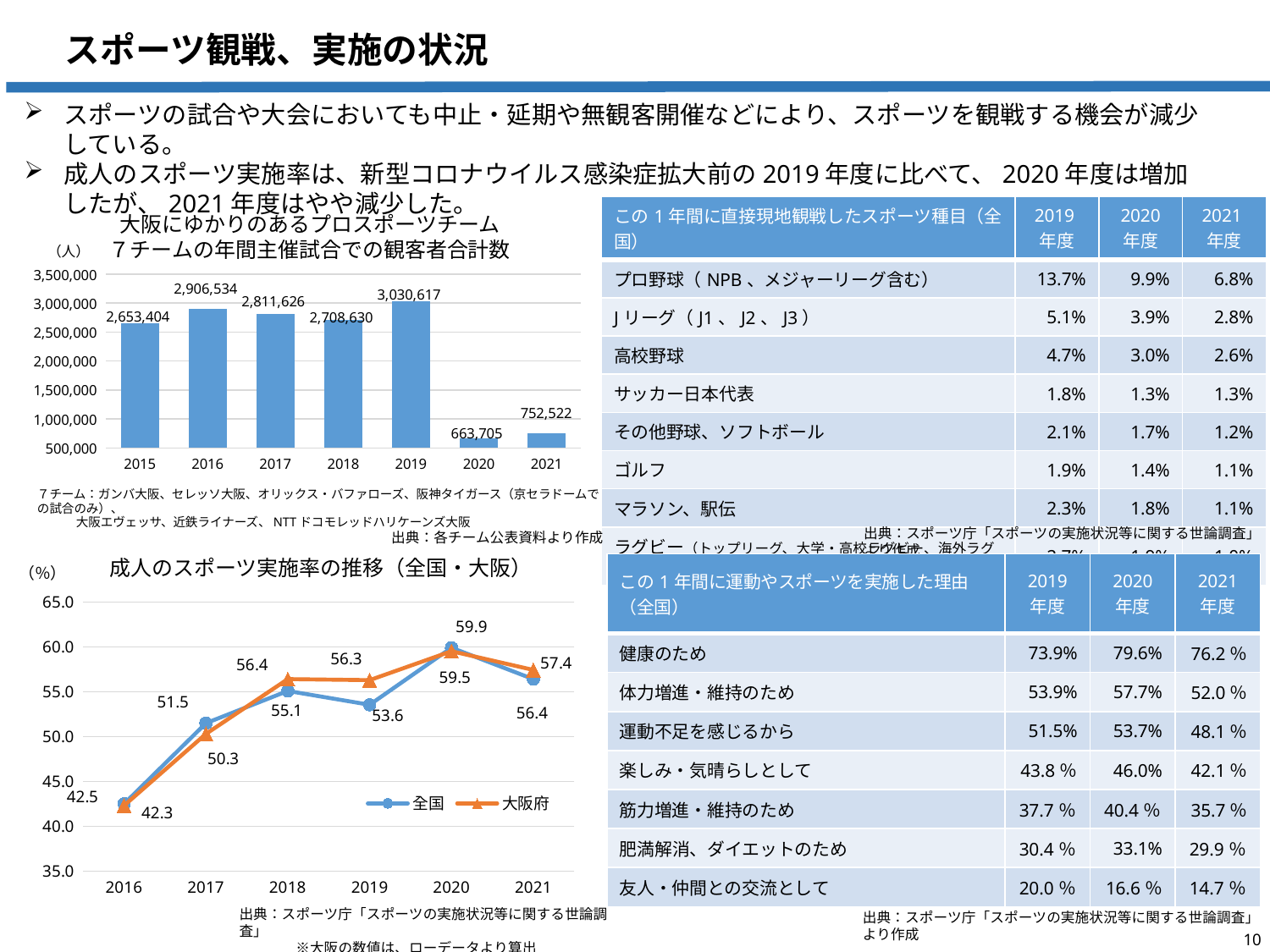
In the bar chart of spectator totals for the 7 Osaka-related pro sports teams, what is the value for 2020? 663,705 In the bar chart of spectator totals for the 7 Osaka-related pro sports teams, which year has the lowest value? 2020 In the bar chart of spectator totals for the 7 Osaka-related pro sports teams, what is the value for 2019? 3,030,617 In the line chart 成人のスポーツ実施率の推移（全国・大阪）, which is larger in 2019, 全国 or 大阪府? 大阪府 In the line chart 成人のスポーツ実施率の推移（全国・大阪）, what is the difference between the 全国 values for 2020 and 2021? 3.5 In the bar chart of spectator totals for the 7 Osaka-related pro sports teams, how many years are shown? 7 What type of chart is the chart titled 大阪にゆかりのあるプロスポーツチーム７チームの年間主催試合での観客者合計数? bar chart In the line chart 成人のスポーツ実施率の推移（全国・大阪）, what is the 大阪府 value for 2017? 50.3 In the line chart 成人のスポーツ実施率の推移（全国・大阪）, what is the 全国 value for 2020? 59.9 In the line chart 成人のスポーツ実施率の推移（全国・大阪）, how many series does the legend list? 2 In the bar chart of spectator totals for the 7 Osaka-related pro sports teams, what is the difference between the 2019 and 2020 values? 2,366,912 In the bar chart of spectator totals for the 7 Osaka-related pro sports teams, which year has the highest value? 2019